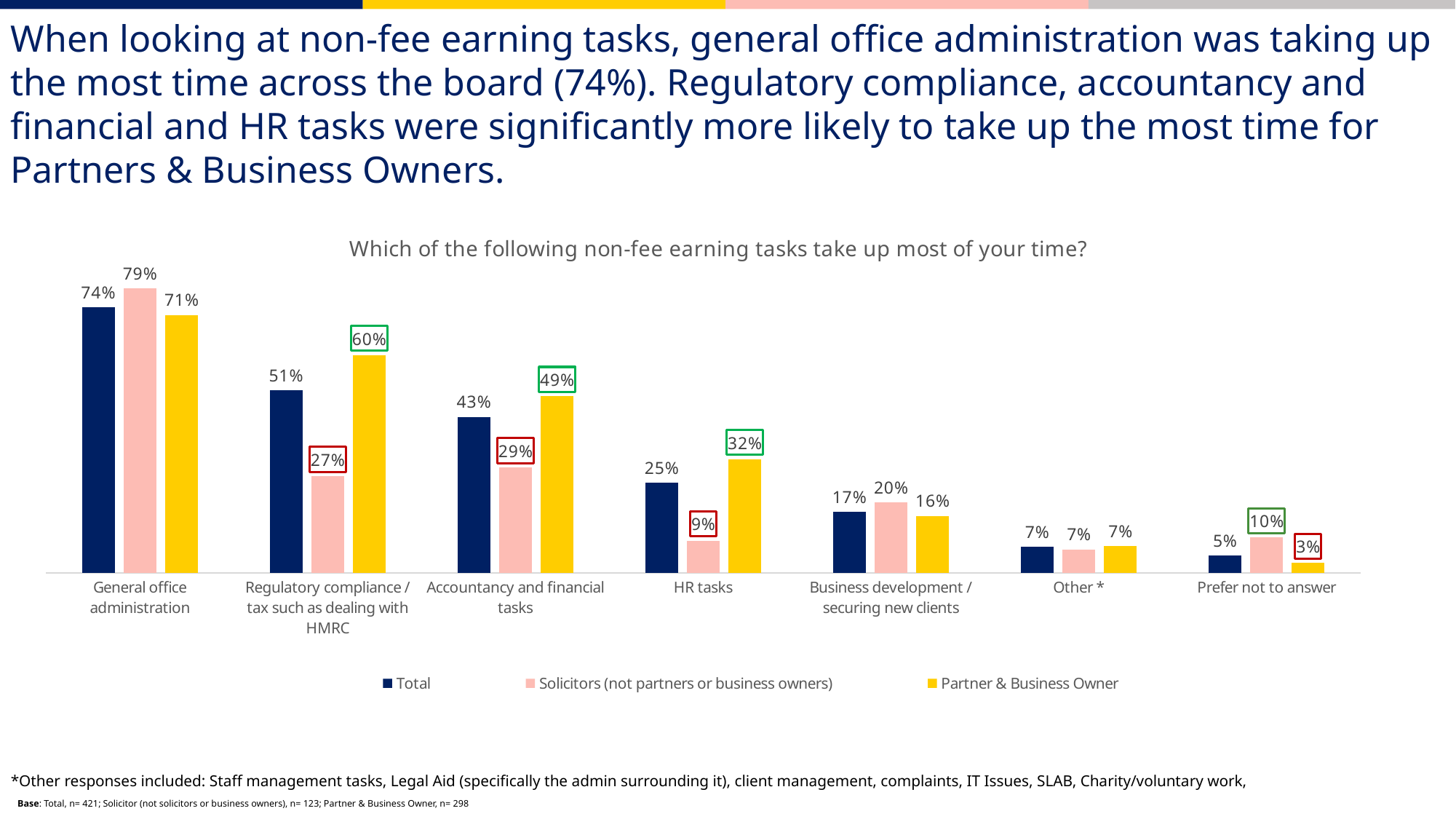
What is the difference between the Partner & Business Owner and Solicitors values for Accountancy and financial tasks? 20 percentage points What kind of chart is shown on the slide? Bar chart What is the title of the chart? Which of the following non-fee earning tasks take up most of your time? Which category has the lowest Partner & Business Owner value? Prefer not to answer What is the Solicitors (not partners or business owners) value for HR tasks? 9% For Business development / securing new clients, which is larger: the Solicitors value or the Partner & Business Owner value? Solicitors (not partners or business owners) Which category has the highest Total value? General office administration How many series does the legend list? 3 How many categories are shown on the x axis? 7 Which colour represents the Partner & Business Owner series? Yellow What is the Partner & Business Owner value for Regulatory compliance / tax such as dealing with HMRC? 60% What is the Total value for General office administration? 74%